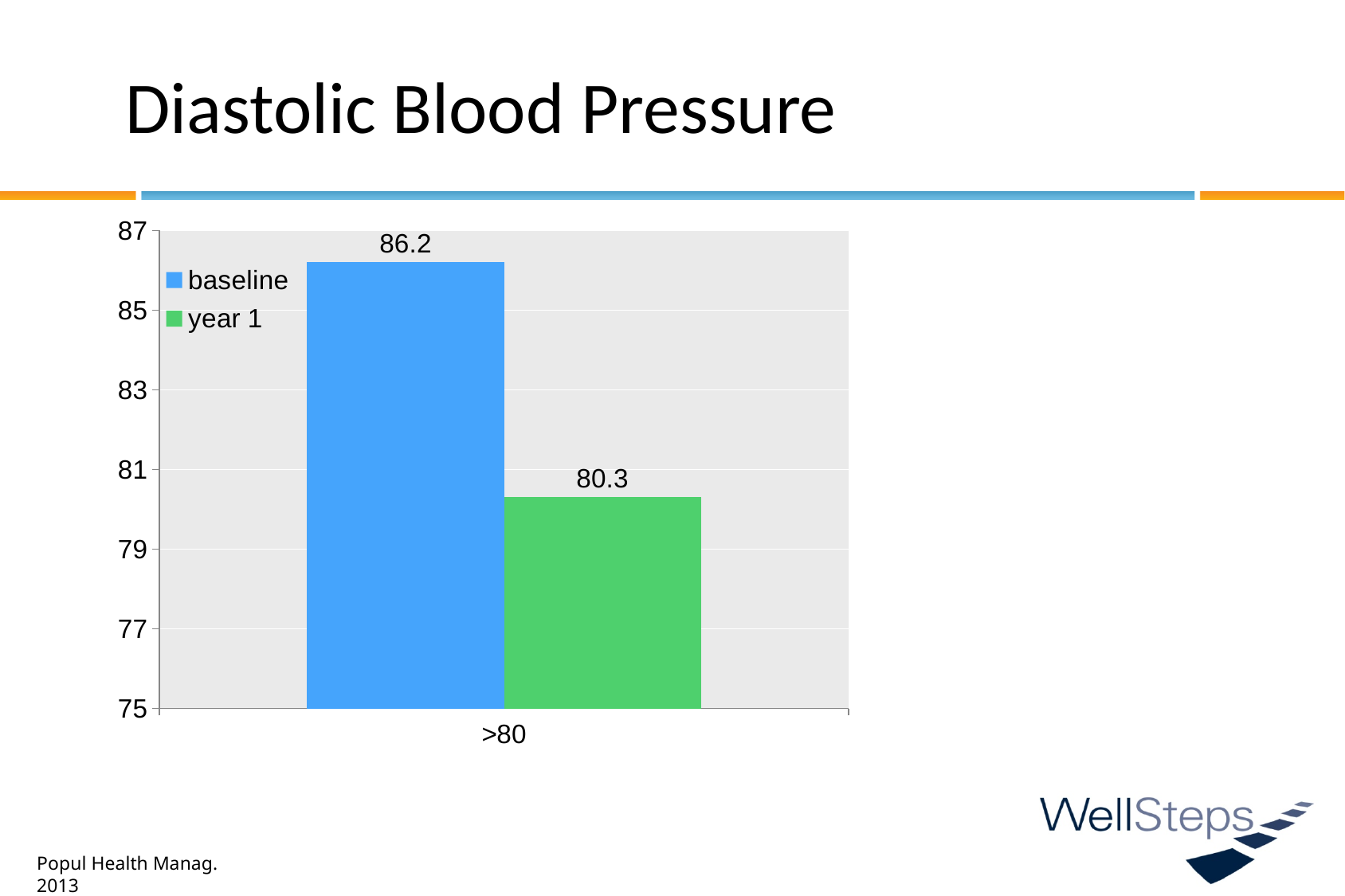
Is the baseline value for the >80 category greater or less than 85? greater Which series has the higher value for the >80 category, baseline or year 1? baseline What is the baseline value for the >80 category? 86.2 How many categories are shown on the x axis? 1 Is the year 1 value for the >80 category greater or less than 81? less How many series does the legend list? 2 What is the title of the slide containing the chart? Diastolic Blood Pressure What is the difference between the baseline and year 1 values for the >80 category? 5.9 What is the label of the category on the x axis? >80 What colour is the year 1 bar? green What kind of chart is shown on the slide? bar chart What is the year 1 value for the >80 category? 80.3